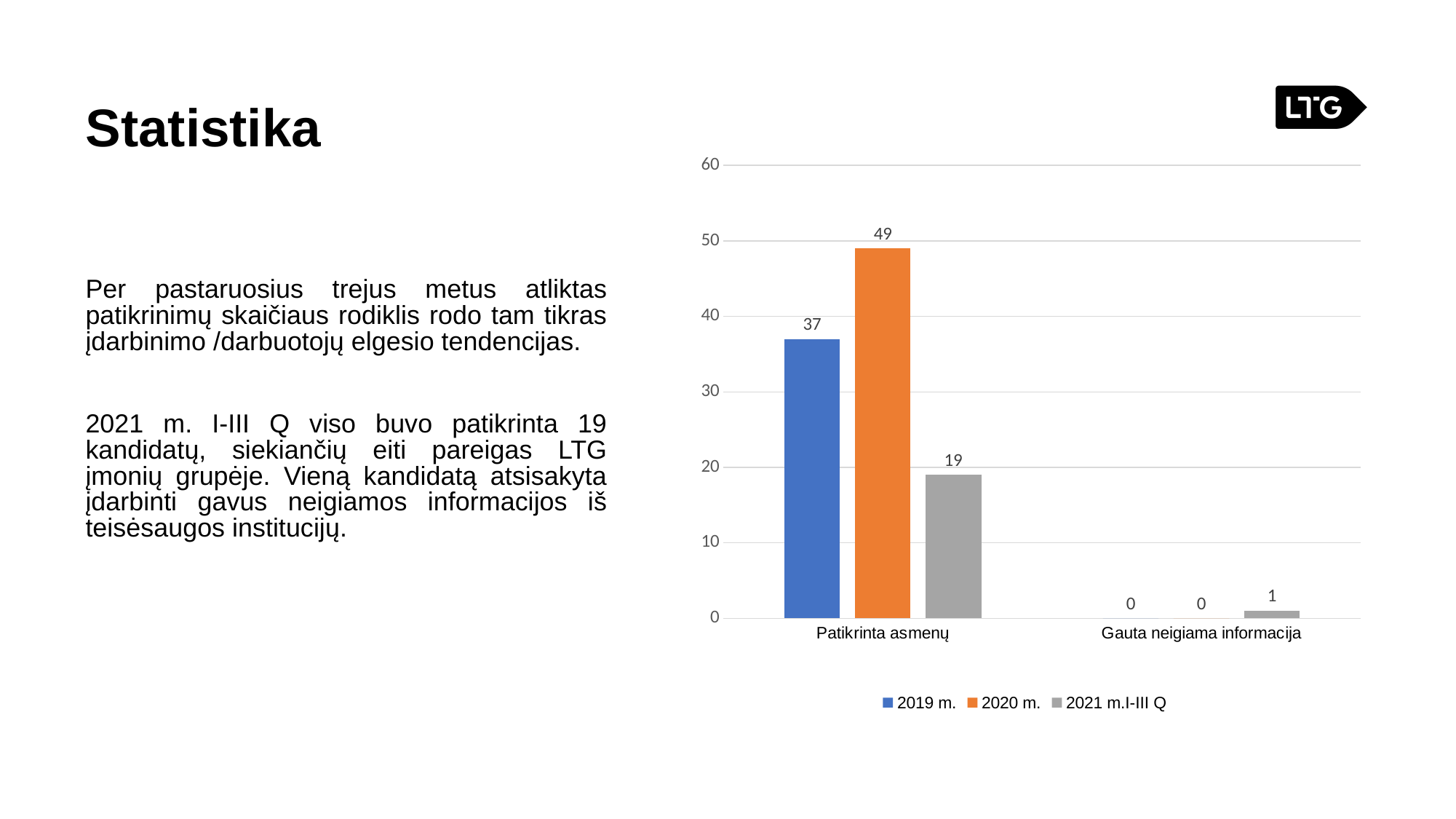
What is the value for 2021 m.I-III Q in the Patikrinta asmenų category? 19 What kind of chart is shown on the slide? Bar chart What is the difference between the 2020 m. and 2019 m. values in the Patikrinta asmenų category? 12 What colour are the 2020 m. bars? Orange What is the value for 2021 m.I-III Q in the Gauta neigiama informacija category? 1 How many series does the legend list? 3 How many categories are shown on the x axis? 2 What is the value for 2019 m. in the Patikrinta asmenų category? 37 Which is larger in the Patikrinta asmenų category: 2019 m. or 2021 m.I-III Q? 2019 m. What is the value for 2020 m. in the Patikrinta asmenų category? 49 Which series has the highest value in the Patikrinta asmenų category? 2020 m. Which series has the lowest value in the Patikrinta asmenų category? 2021 m.I-III Q